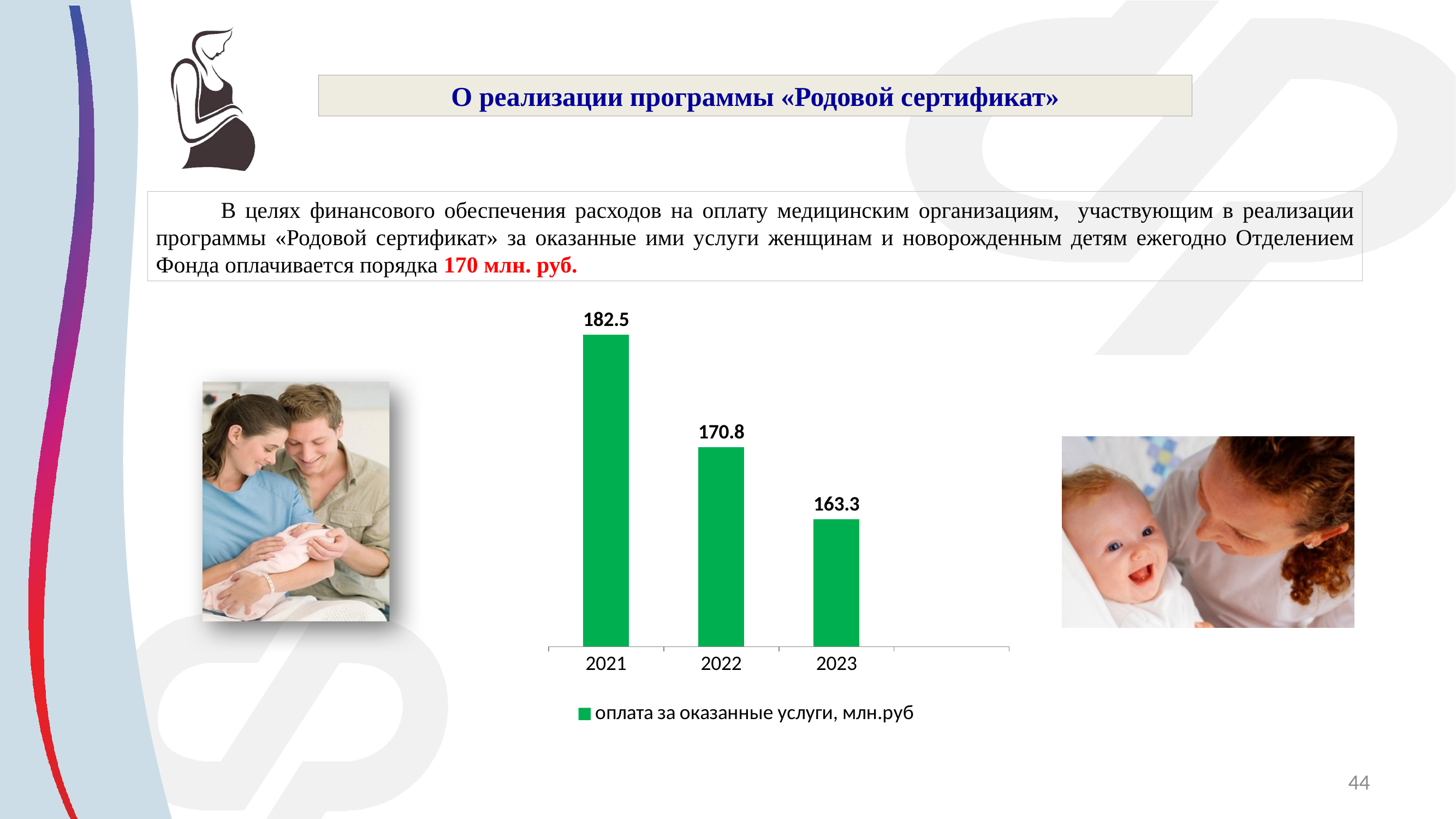
Do the values rise or fall from 2021 to 2023? fall Which year has the highest value? 2021 How many series does the legend list? 1 What is the difference between the values for 2021 and 2023? 19.2 Which year has the lowest value? 2023 What is the value for 2021? 182.5 What is the value for 2023? 163.3 What is the value for 2022? 170.8 What kind of chart is shown on the slide? bar chart What is the difference between the values for 2021 and 2022? 11.7 How many years are shown on the chart? 3 Which is larger, the value for 2022 or the value for 2023? 2022